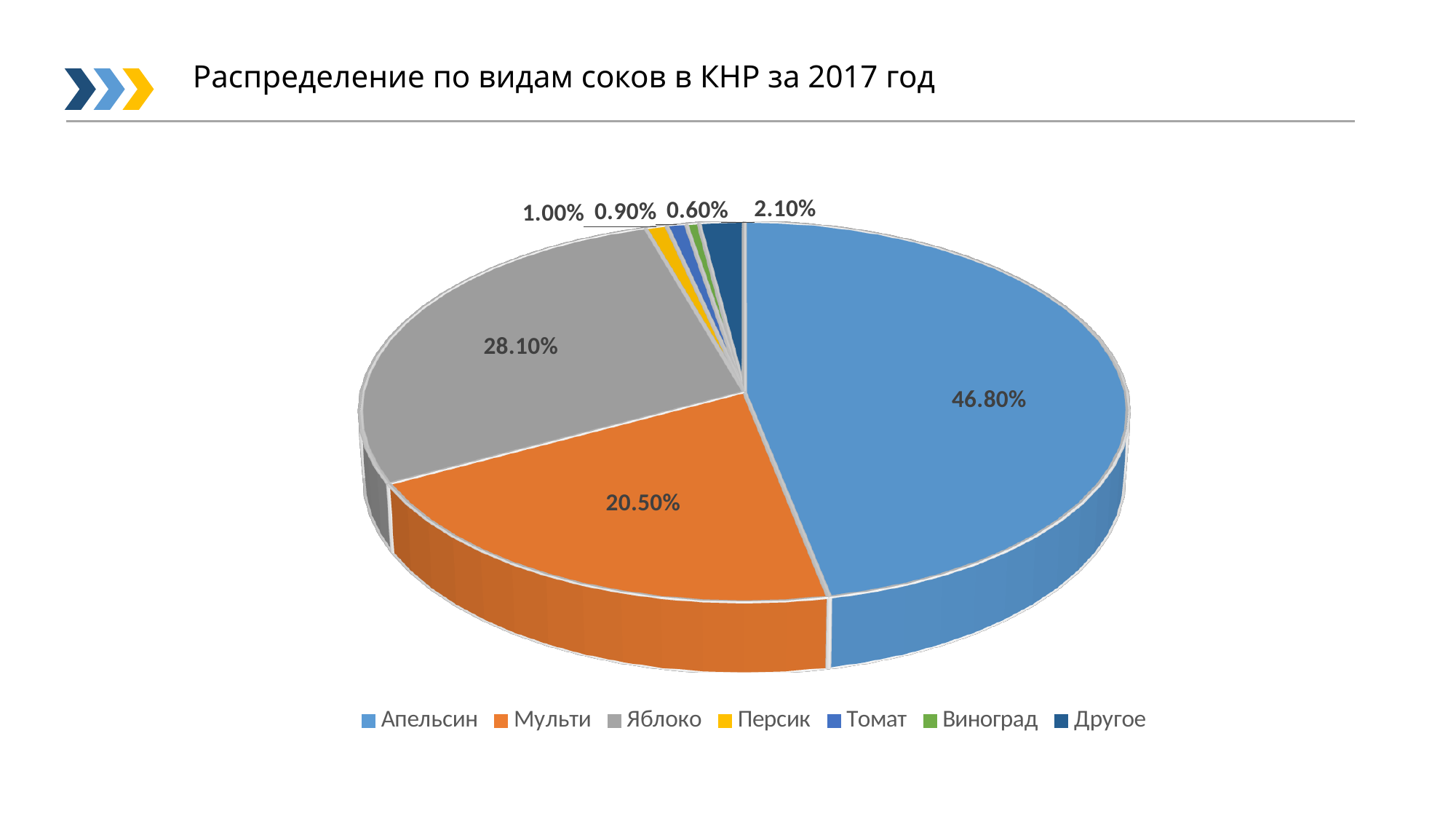
What is the value for Яблоко? 28.10% What share of the pie does Апельсин have? 46.80% What is the value for Виноград? 0.60% What is the title of the chart? Распределение по видам соков в КНР за 2017 год Which category has the smallest share of the pie? Виноград What is the difference between the shares of Яблоко and Мульти? 7.60% What is the value for Мульти? 20.50% Which is larger, the share of Персик or the share of Томат? Персик What is the value for Другое? 2.10% Which category has the largest share of the pie? Апельсин How many categories does the legend list? 7 What kind of chart is shown on the slide? pie chart